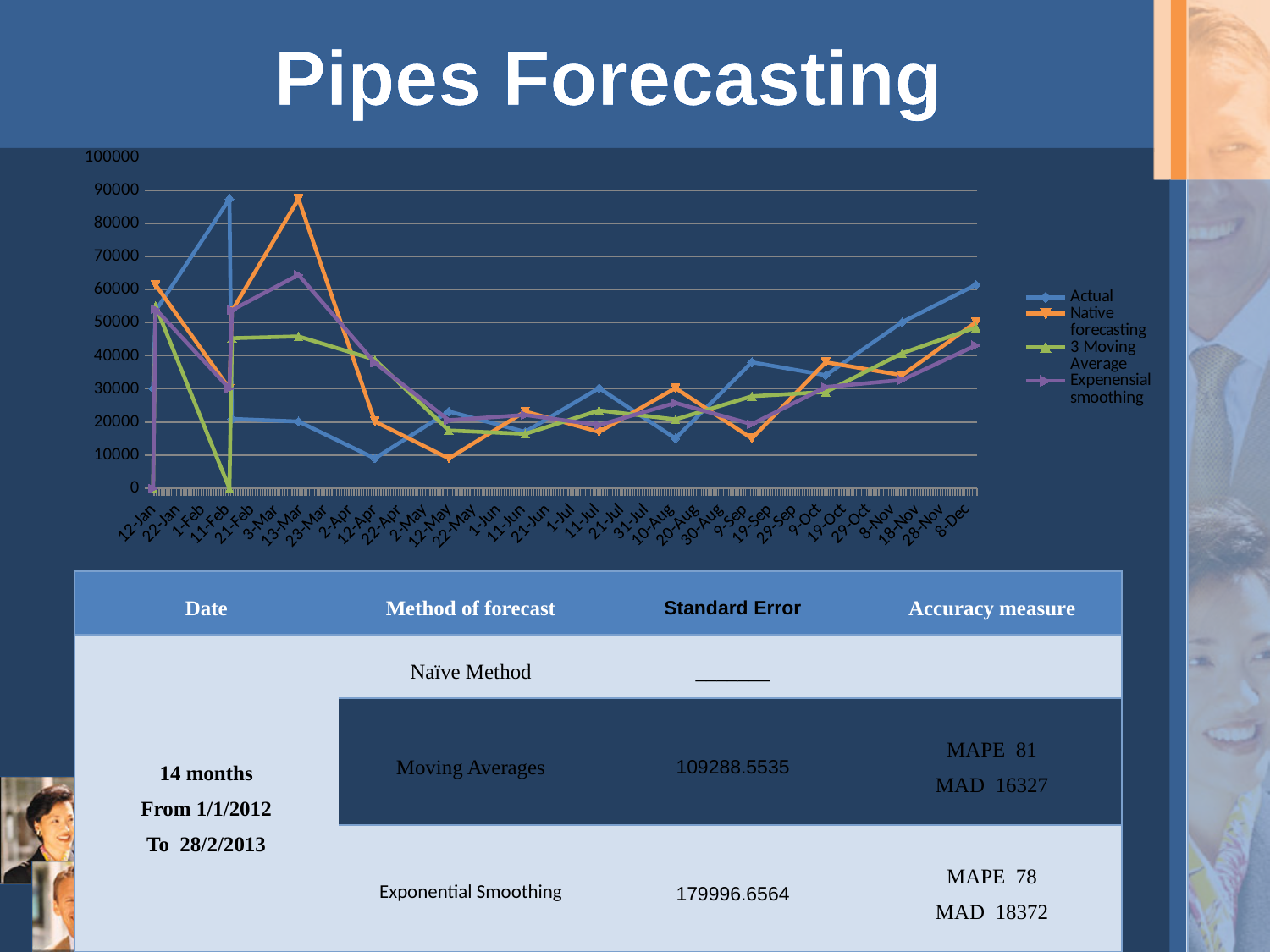
Which series is listed first in the chart legend? Actual Is the value of the Native forecasting series at 22-Apr greater or less than 30000? less What is the highest value shown on the chart's vertical axis? 100000 Does the Actual series rise or fall between 9-Oct and 8-Dec? rise Is the value of the Native forecasting series at 13-Mar greater or less than 80000? greater Is the value of the Actual series at 8-Dec greater or less than 50000? greater At 13-Mar, which series has the larger value: Native forecasting or Actual? Native forecasting How many series does the chart legend list? 4 What kind of chart is shown on the slide? line chart